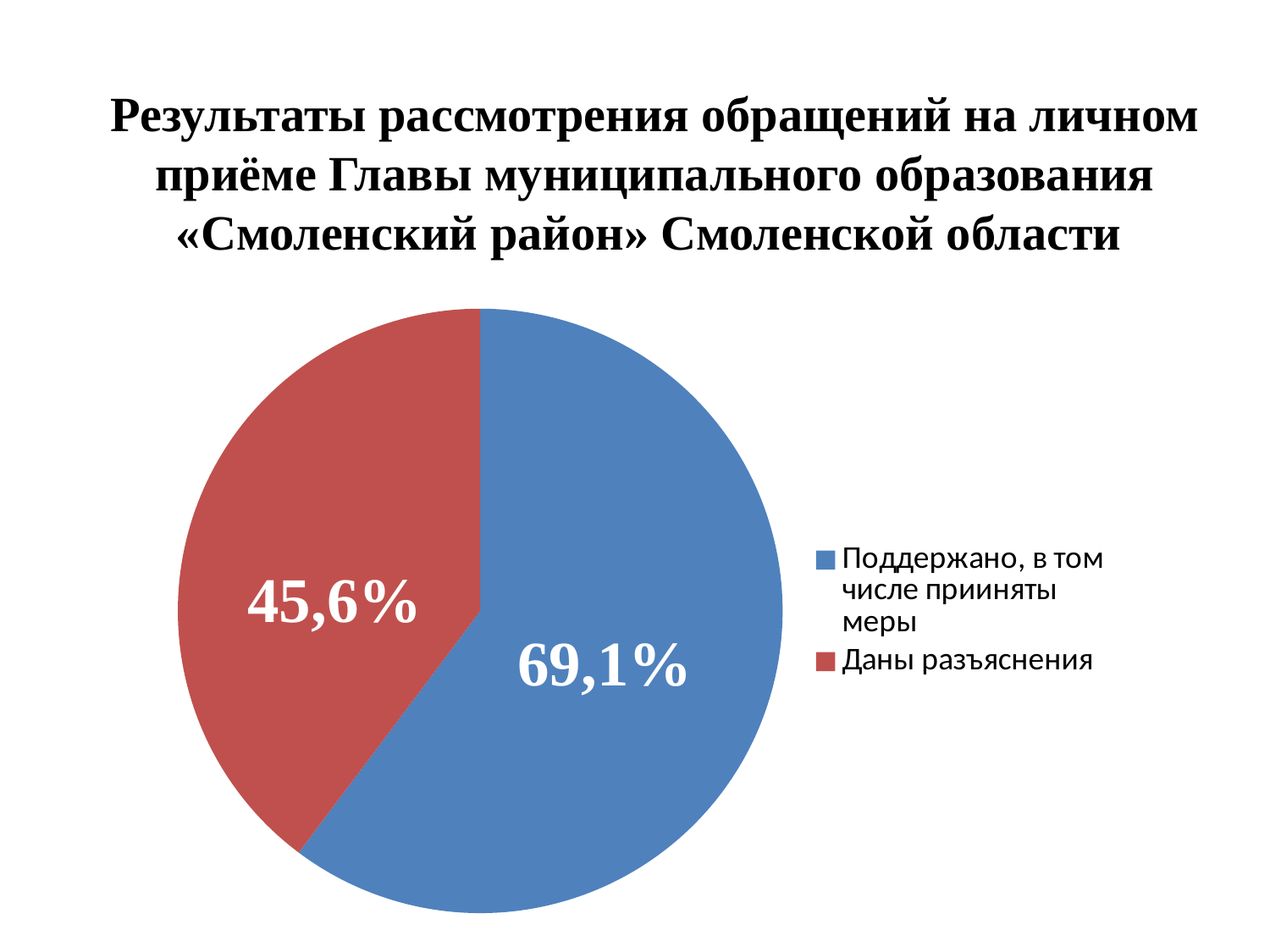
What kind of chart is shown on the slide? Pie chart What is the difference between the value for "Поддержано, в том числе приняты меры" and the value for "Даны разъяснения"? 23,5% What colour is the slice for "Поддержано, в том числе приняты меры"? Blue How many slices does the pie chart have? 2 How many entries does the legend list? 2 What value is shown for the slice "Поддержано, в том числе приняты меры"? 69,1% Which category has the largest slice of the pie? Поддержано, в том числе приняты меры Which category has the smallest slice of the pie? Даны разъяснения What colour is the slice for "Даны разъяснения"? Red What value is shown for the slice "Даны разъяснения"? 45,6% Which is larger: the value for "Поддержано, в том числе приняты меры" or the value for "Даны разъяснения"? Поддержано, в том числе приняты меры